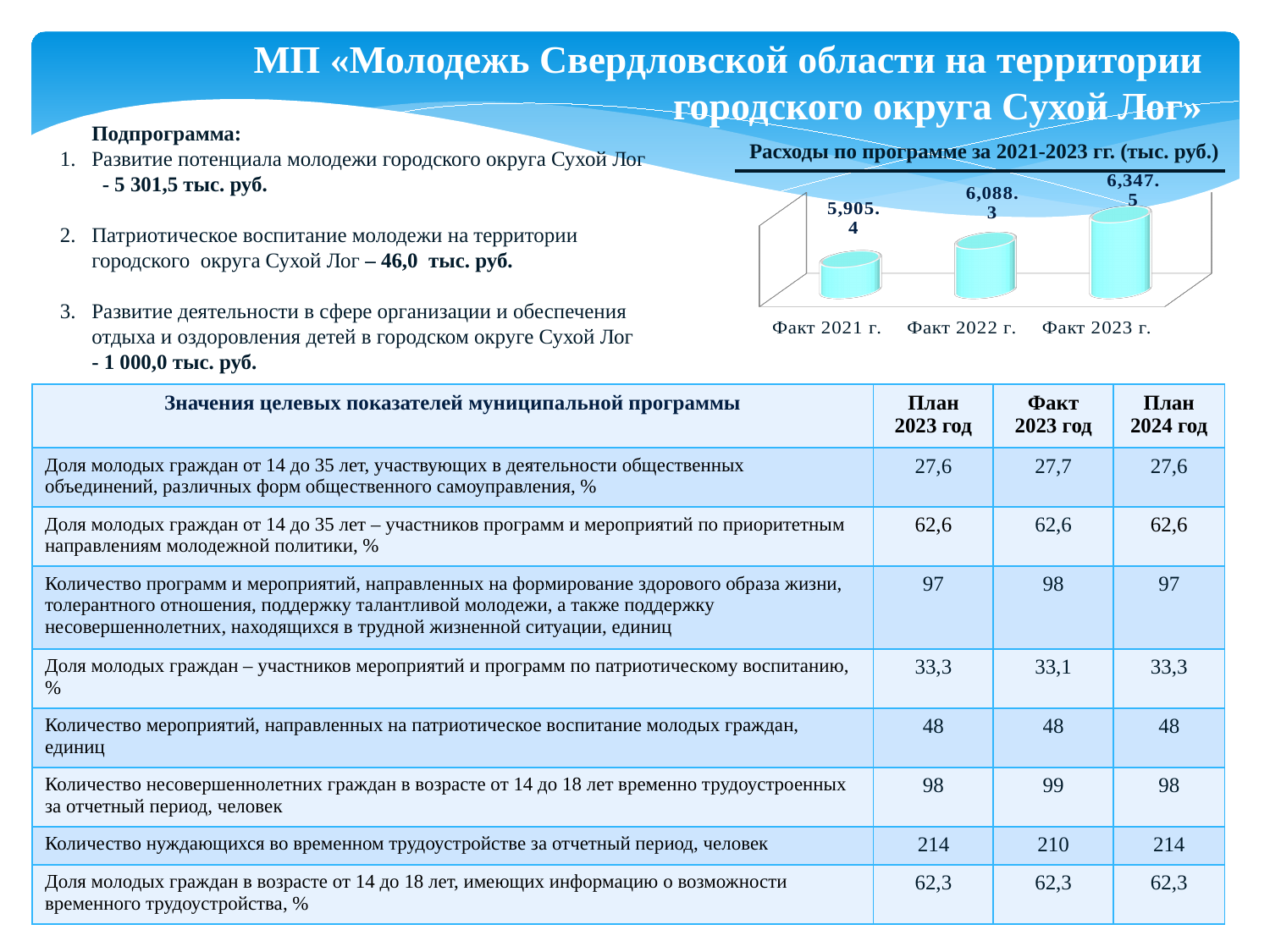
In the chart «Расходы по программе за 2021-2023 гг. (тыс. руб.)», what is the difference between the values for Факт 2022 г. and Факт 2021 г.? 182.9 What is the value for Факт 2023 г. in the chart «Расходы по программе за 2021-2023 гг. (тыс. руб.)»? 6,347.5 What is the value for Факт 2022 г. in the chart «Расходы по программе за 2021-2023 гг. (тыс. руб.)»? 6,088.3 What is the value for Факт 2021 г. in the chart «Расходы по программе за 2021-2023 гг. (тыс. руб.)»? 5,905.4 In the chart «Расходы по программе за 2021-2023 гг. (тыс. руб.)», which is larger: the value for Факт 2022 г. or Факт 2023 г.? Факт 2023 г. How many categories are shown in the chart «Расходы по программе за 2021-2023 гг. (тыс. руб.)»? 3 Do the values in the chart «Расходы по программе за 2021-2023 гг. (тыс. руб.)» rise or fall from Факт 2021 г. to Факт 2023 г.? Rise In the chart «Расходы по программе за 2021-2023 гг. (тыс. руб.)», what is the difference between the values for Факт 2023 г. and Факт 2022 г.? 259.2 Which category has the highest value in the chart «Расходы по программе за 2021-2023 гг. (тыс. руб.)»? Факт 2023 г. What kind of chart is «Расходы по программе за 2021-2023 гг. (тыс. руб.)»? Bar chart In the chart «Расходы по программе за 2021-2023 гг. (тыс. руб.)», what is the difference between the values for Факт 2023 г. and Факт 2021 г.? 442.1 Which category has the lowest value in the chart «Расходы по программе за 2021-2023 гг. (тыс. руб.)»? Факт 2021 г.